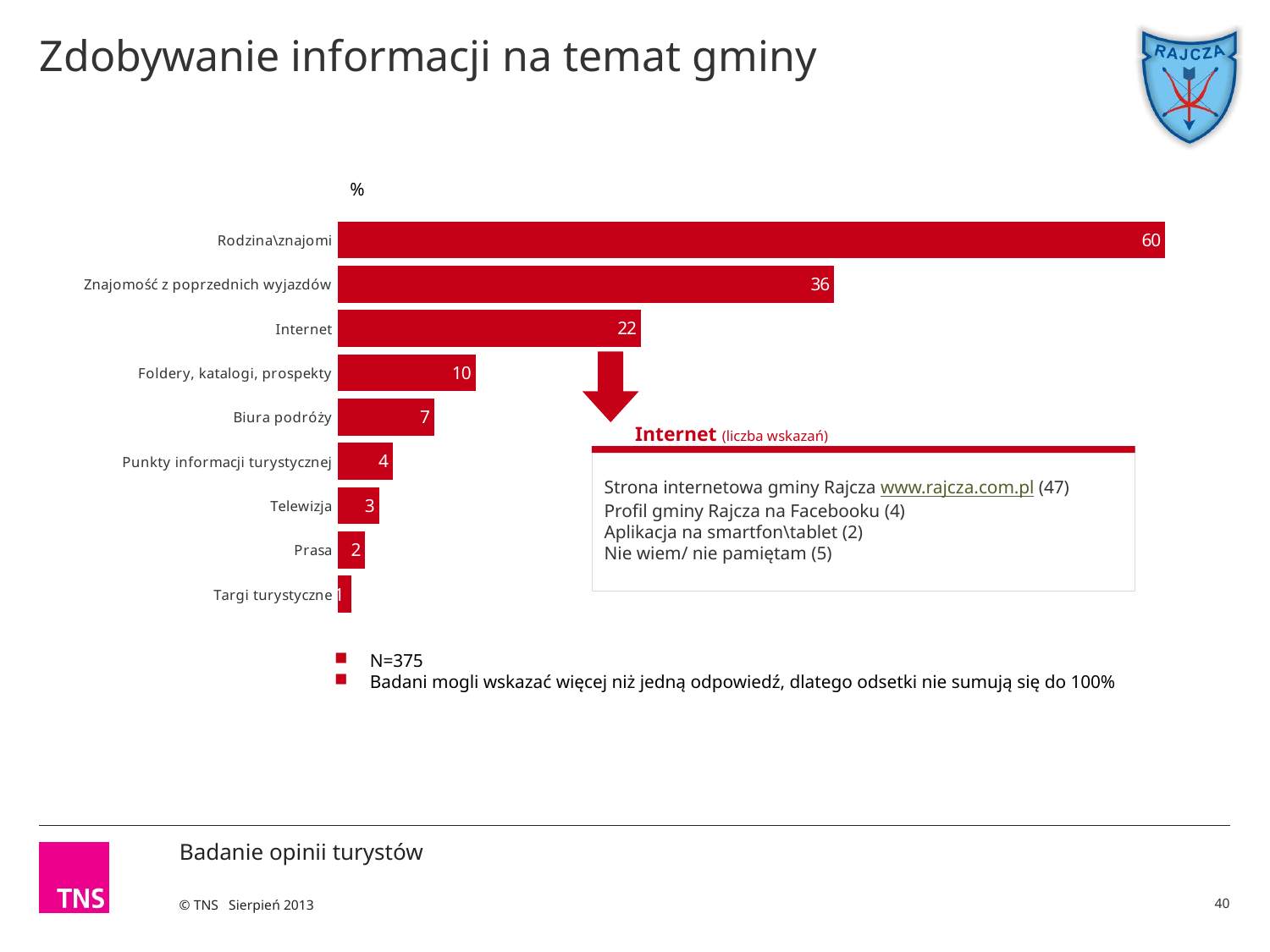
What is the difference between the values for Rodzina\znajomi and Znajomość z poprzednich wyjazdów? 24 What is the value for Telewizja? 3 Which is larger, the value for Punkty informacji turystycznej or the value for Prasa? Punkty informacji turystycznej What is the value for Internet? 22 What kind of chart is shown on the slide? Bar chart What is the value for Rodzina\znajomi? 60 What is the difference between the values for Internet and Biura podróży? 15 How many categories are shown in the bar chart? 9 Which category has the lowest value? Targi turystyczne Which category has the highest value? Rodzina\znajomi What is the value for Foldery, katalogi, prospekty? 10 What is the title of the slide containing the chart? Zdobywanie informacji na temat gminy